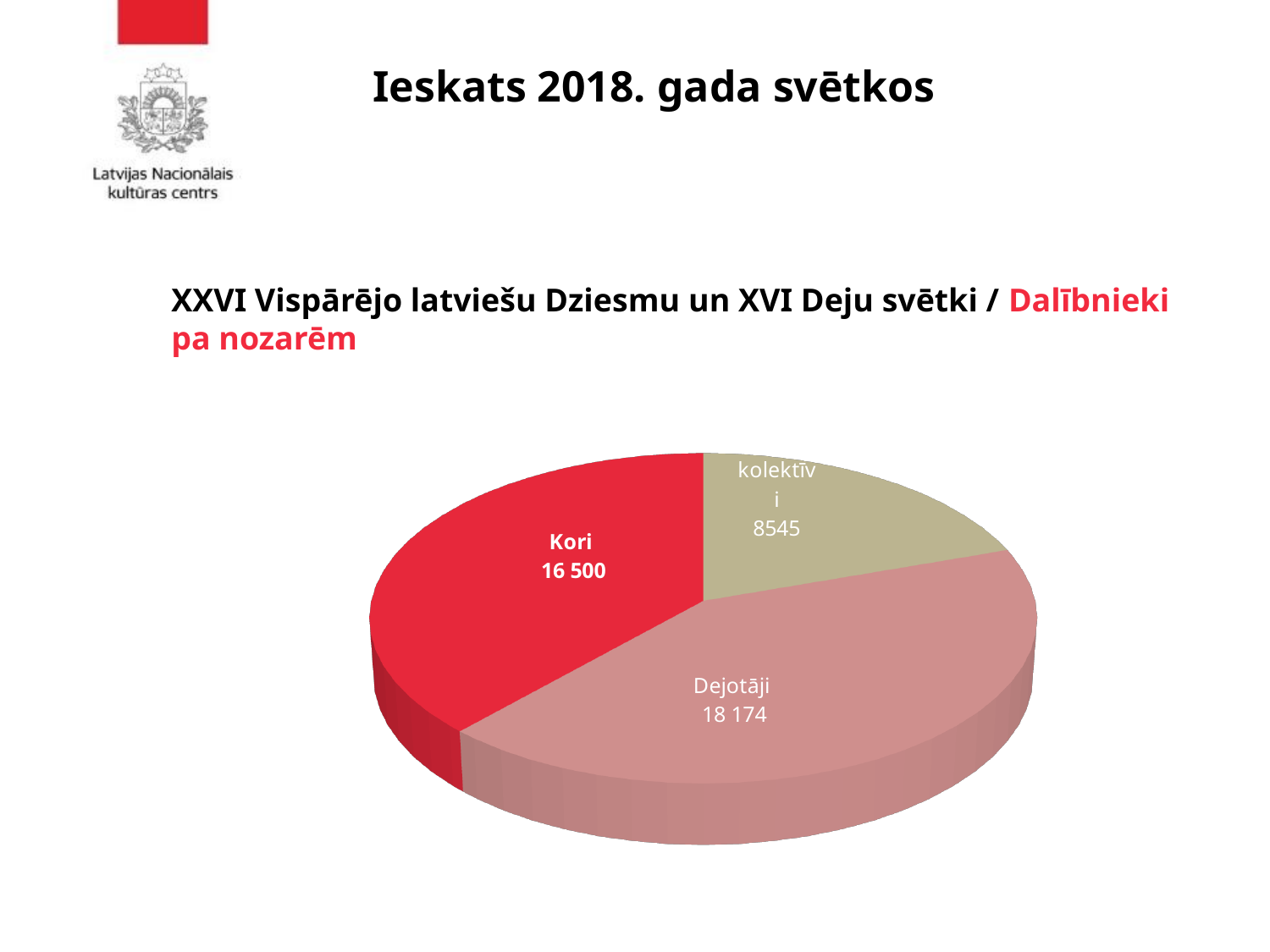
What is the value shown for the Kori slice of the pie chart? 16 500 What is the total of all three values shown in the pie chart? 43 219 What colour is the Kori slice in the pie chart? Red What is the value shown for the slice labelled kolektīvi in the pie chart? 8545 What kind of chart is shown on the slide? Pie chart Which category has the smallest slice in the pie chart? kolektīvi What is the value shown for the Dejotāji slice of the pie chart? 18 174 How many slices does the pie chart have? 3 Which is larger in the pie chart, Kori or Dejotāji? Dejotāji How much larger is the Dejotāji value than the Kori value in the pie chart? 1 674 What is the difference between the Kori value and the kolektīvi value in the pie chart? 7 955 Which category has the largest slice in the pie chart? Dejotāji